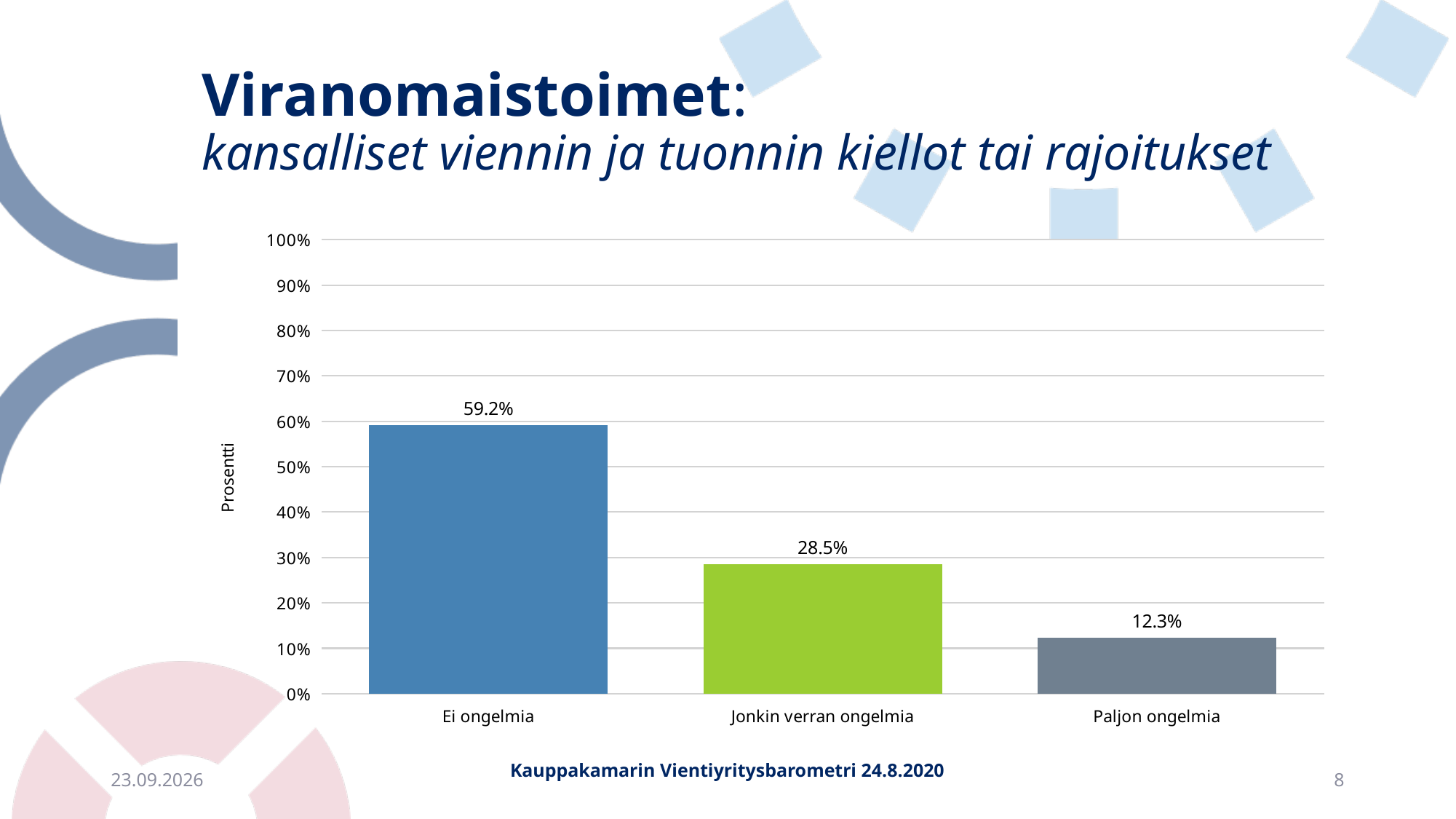
Which category has the highest value? Ei ongelmia What is the difference between the values for Ei ongelmia and Jonkin verran ongelmia? 30.7% Is the value for Ei ongelmia greater or less than 50%? greater Which is larger, the value for Jonkin verran ongelmia or the value for Paljon ongelmia? Jonkin verran ongelmia What is the value for Ei ongelmia? 59.2% What is the value for Paljon ongelmia? 12.3% What is the label of the y axis? Prosentti What is the value for Jonkin verran ongelmia? 28.5% How many categories are shown on the x axis? 3 What kind of chart is shown on the slide? bar chart What is the difference between the values for Jonkin verran ongelmia and Paljon ongelmia? 16.2% Which category has the lowest value? Paljon ongelmia